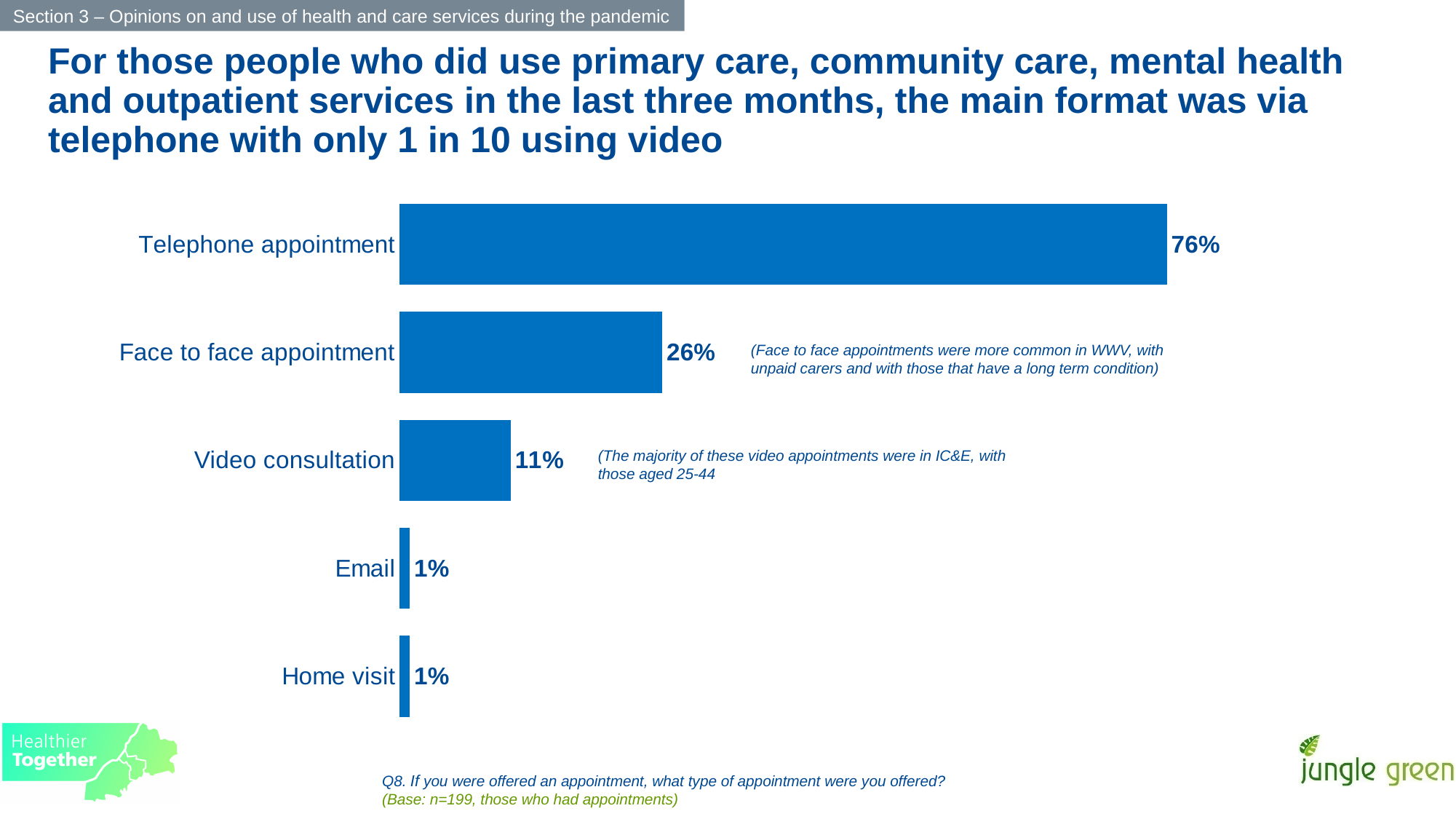
What kind of chart is shown on the slide? Bar chart What is the difference between the Telephone appointment and Face to face appointment values? 50% What is the base size (n) stated for the chart? n=199 How many appointment types are shown in the chart? 5 What is the value shown for Email? 1% What percentage were offered a video consultation? 11% Which appointment type has the highest value? Telephone appointment What is the value shown for Face to face appointment? 26% What percentage of respondents were offered a telephone appointment? 76% Which two appointment types share the same value of 1%? Email and Home visit Which is larger, the value for Video consultation or the value for Home visit? Video consultation What is the difference between the Face to face appointment and Video consultation values? 15%